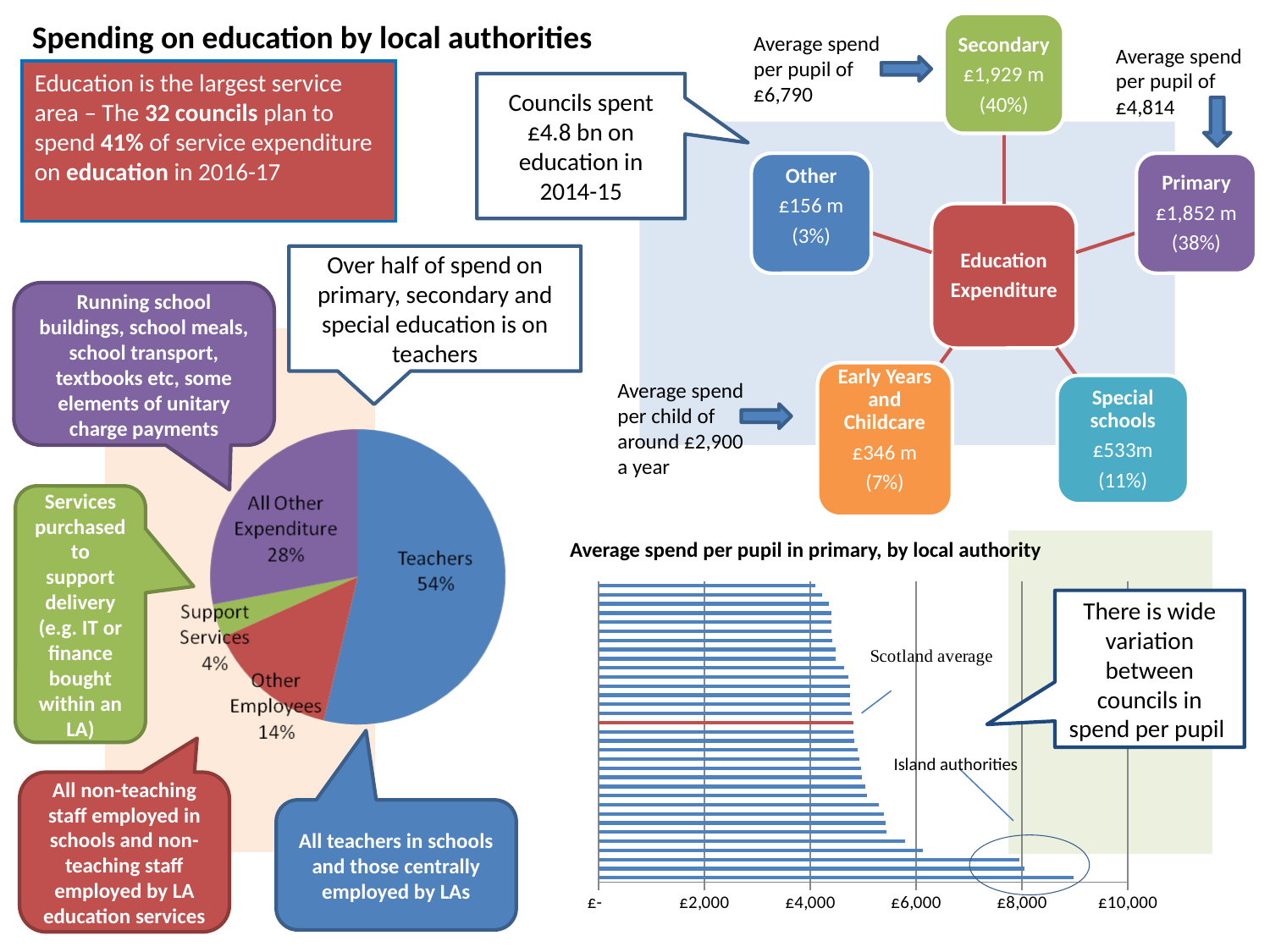
How many categories does the pie chart show? 4 What type of chart is the chart titled 'Average spend per pupil in primary, by local authority'? Bar chart In the pie chart, what share of spend goes to All Other Expenditure? 28% In the pie chart, what share of spend goes to Teachers? 54% In the chart 'Average spend per pupil in primary, by local authority', is the Scotland average bar greater or less than £6,000? less In the pie chart, what share of spend goes to Support Services? 4% In the chart 'Average spend per pupil in primary, by local authority', is the value of the longest bar greater or less than £8,000? greater In the pie chart, which is larger: Other Employees or Support Services? Other Employees In the pie chart, what is the difference in percentage points between Teachers and All Other Expenditure? 26 In the pie chart, which category has the smallest share? Support Services In the pie chart, which category has the largest share? Teachers In the pie chart, what share of spend goes to Other Employees? 14%